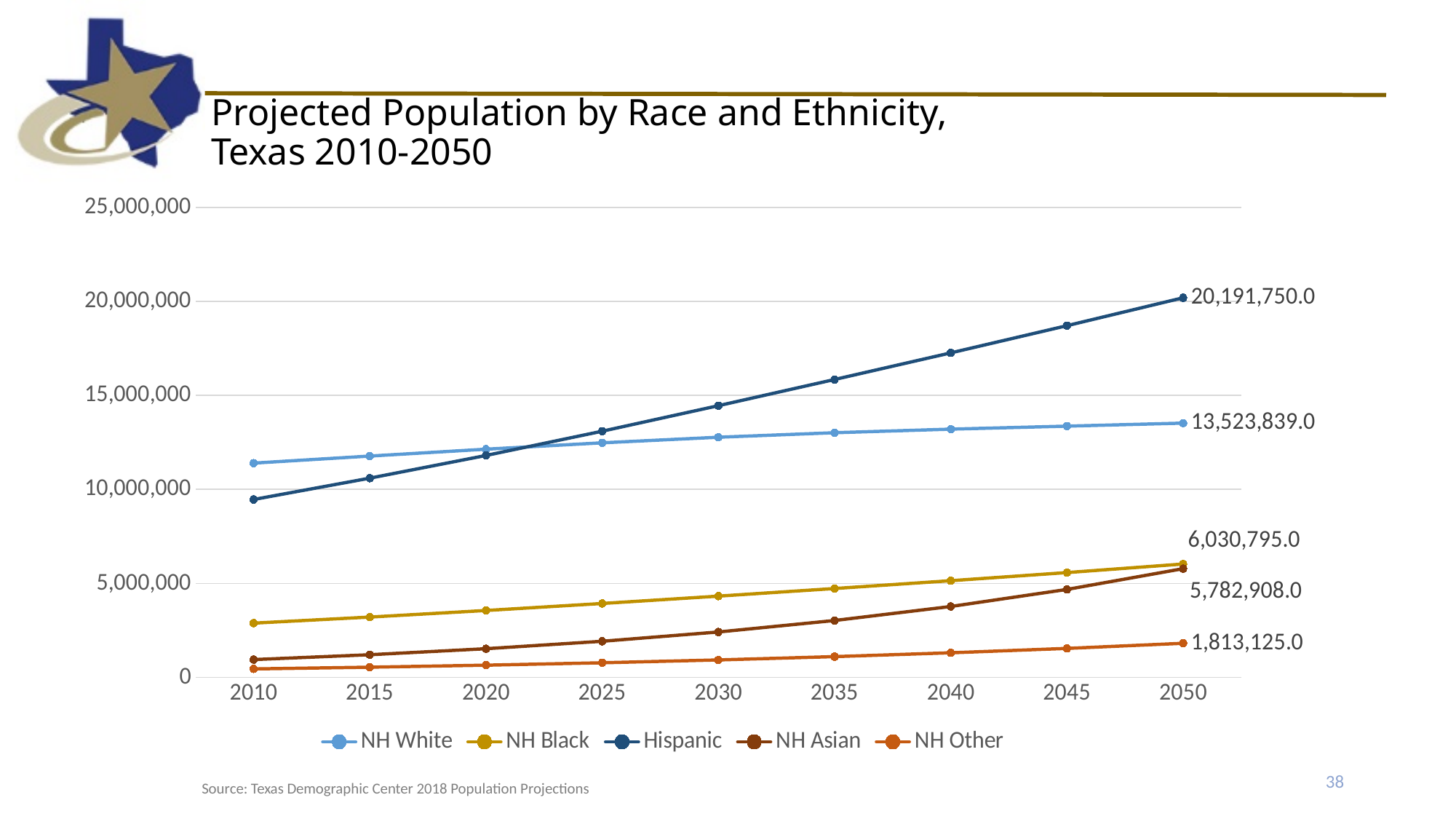
How many series does the legend list? 5 Is the NH White population in 2010 greater or less than 10,000,000? greater What is the difference between the Hispanic and NH White projected populations in 2050? 6,667,911.0 What kind of chart is shown on the slide? Line chart How many years are shown on the x axis? 9 Is the Hispanic population in 2010 greater or less than 10,000,000? less What is the projected Hispanic population in 2050? 20,191,750.0 Which group has the lowest projected population in 2050? NH Other What is the projected NH Other population in 2050? 1,813,125.0 What is the projected NH White population in 2050? 13,523,839.0 In 2050, which is larger: the NH Black or the NH Asian projected population? NH Black Which group has the highest projected population in 2050? Hispanic